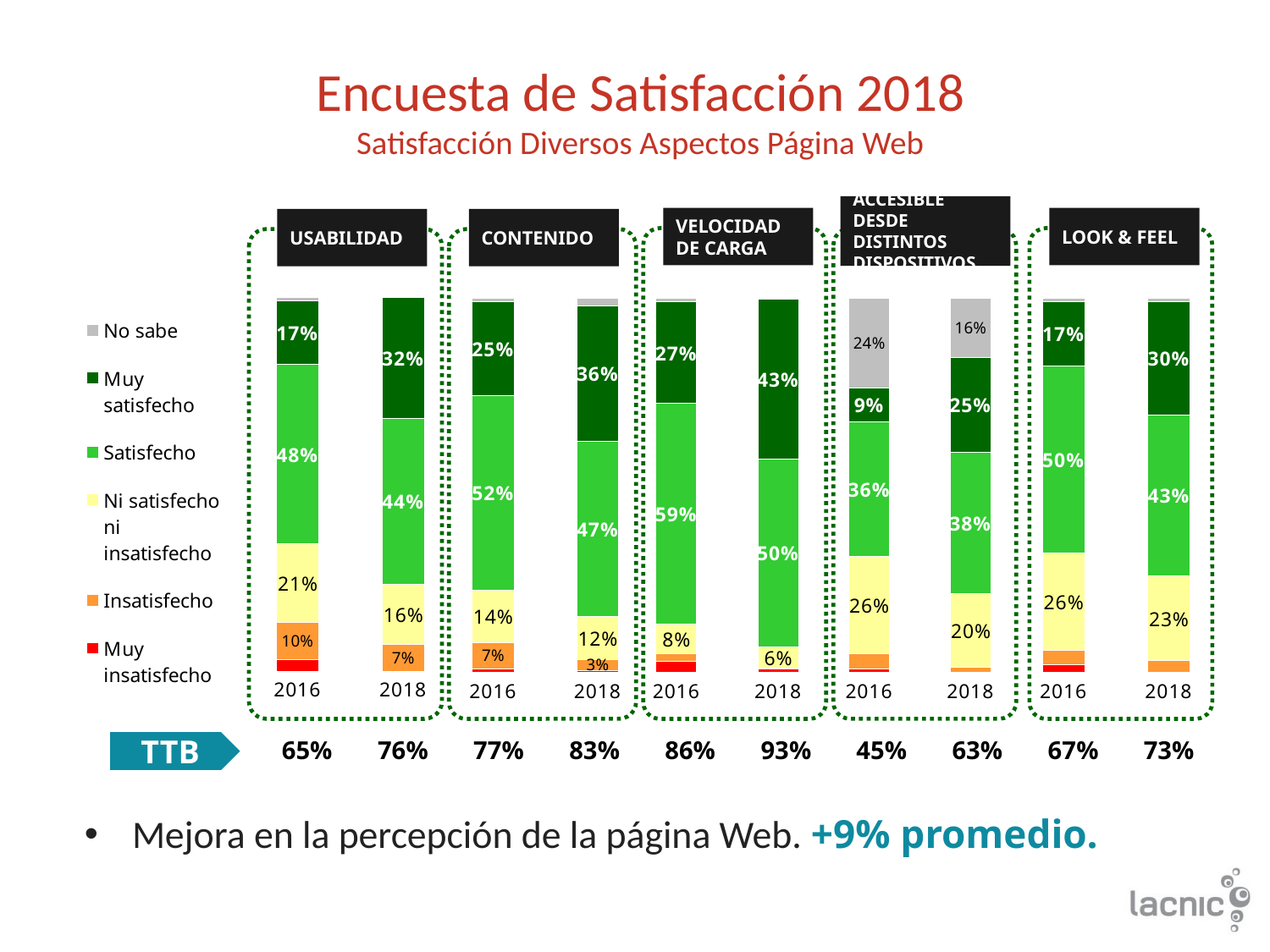
How many series does the legend list? 6 Which bar has the lowest 'Muy satisfecho' value? ACCESIBLE DESDE DISTINTOS DISPOSITIVOS 2016 What is the 'Ni satisfecho ni insatisfecho' value for LOOK & FEEL in 2018? 23% What is the difference between the 'Satisfecho' values for VELOCIDAD DE CARGA in 2016 and 2018? 9% How many bars are plotted in the chart? 10 What is the 'Satisfecho' value for CONTENIDO in 2016? 52% Which bar has the highest 'Muy satisfecho' value? VELOCIDAD DE CARGA 2018 From 2016 to 2018, does the 'Muy satisfecho' value for LOOK & FEEL rise or fall? rise Which is larger, the 'Insatisfecho' value for USABILIDAD in 2016 or for CONTENIDO in 2018? USABILIDAD 2016 What type of chart is shown on the slide? stacked bar chart What is the 'Muy satisfecho' value for USABILIDAD in 2018? 32% What is the 'No sabe' value for ACCESIBLE DESDE DISTINTOS DISPOSITIVOS in 2016? 24%